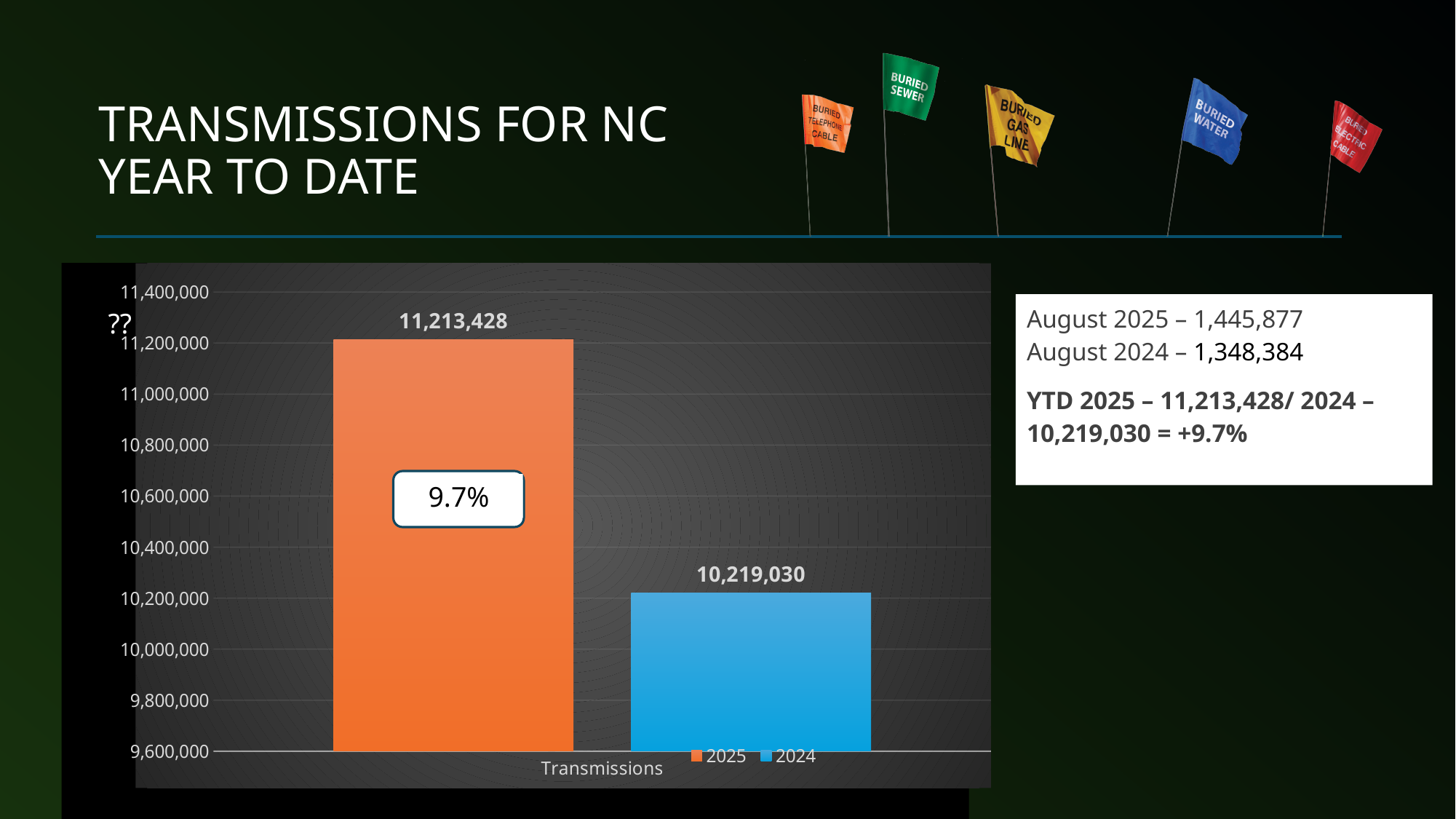
Which series has the higher value, 2025 or 2024? 2025 What is the value of the 2024 bar in the chart? 10,219,030 Is the value for 2024 greater or less than 10,400,000? less How many series does the legend list? 2 What is the category label on the x axis of the chart? Transmissions What is the difference between the 2025 and 2024 values? 994,398 What is the value of the 2025 bar in the chart? 11,213,428 What is the lowest value shown on the y axis of the chart? 9,600,000 Which series has the lowest value in the chart? 2024 What percentage is shown in the callout box on the 2025 bar? 9.7% What kind of chart is shown on the slide? bar chart Is the value for 2025 greater or less than 11,000,000? greater